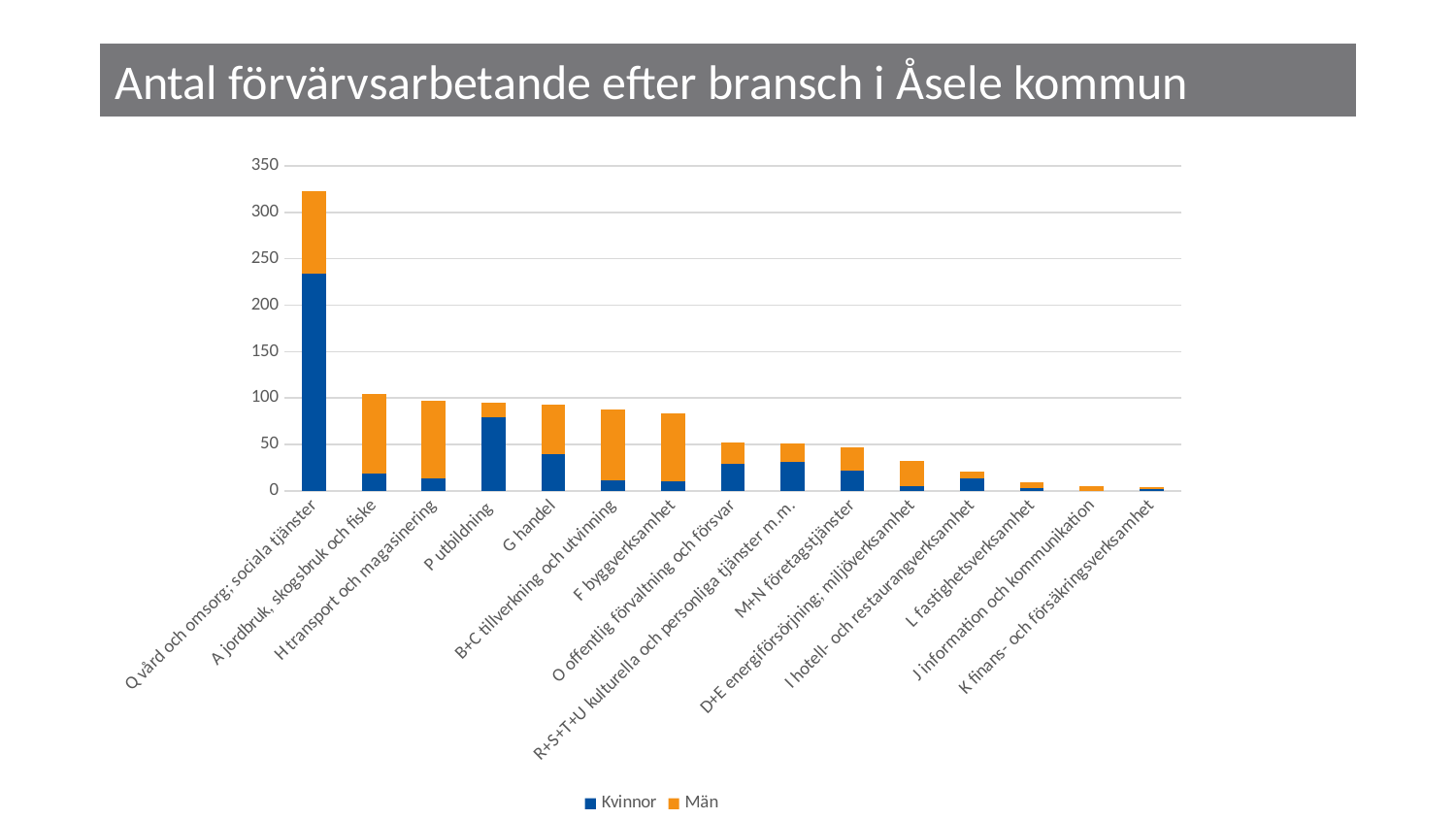
Which two series are listed in the legend? Kvinnor and Män Is the Kvinnor value for P utbildning greater or less than 50? greater How many series does the legend list? 2 Is the total value for F byggverksamhet greater or less than 100? less Is the total value for Q vård och omsorg; sociala tjänster greater or less than 300? greater What kind of chart is shown on the slide? Stacked bar chart Which has a larger total, Q vård och omsorg; sociala tjänster or A jordbruk, skogsbruk och fiske? Q vård och omsorg; sociala tjänster Which category has the highest total number of employed persons? Q vård och omsorg; sociala tjänster How many industry categories are shown on the x axis? 15 Do the total bar heights generally rise or fall from left to right along the x axis? fall Which category has the lowest total number of employed persons? K finans- och försäkringsverksamhet